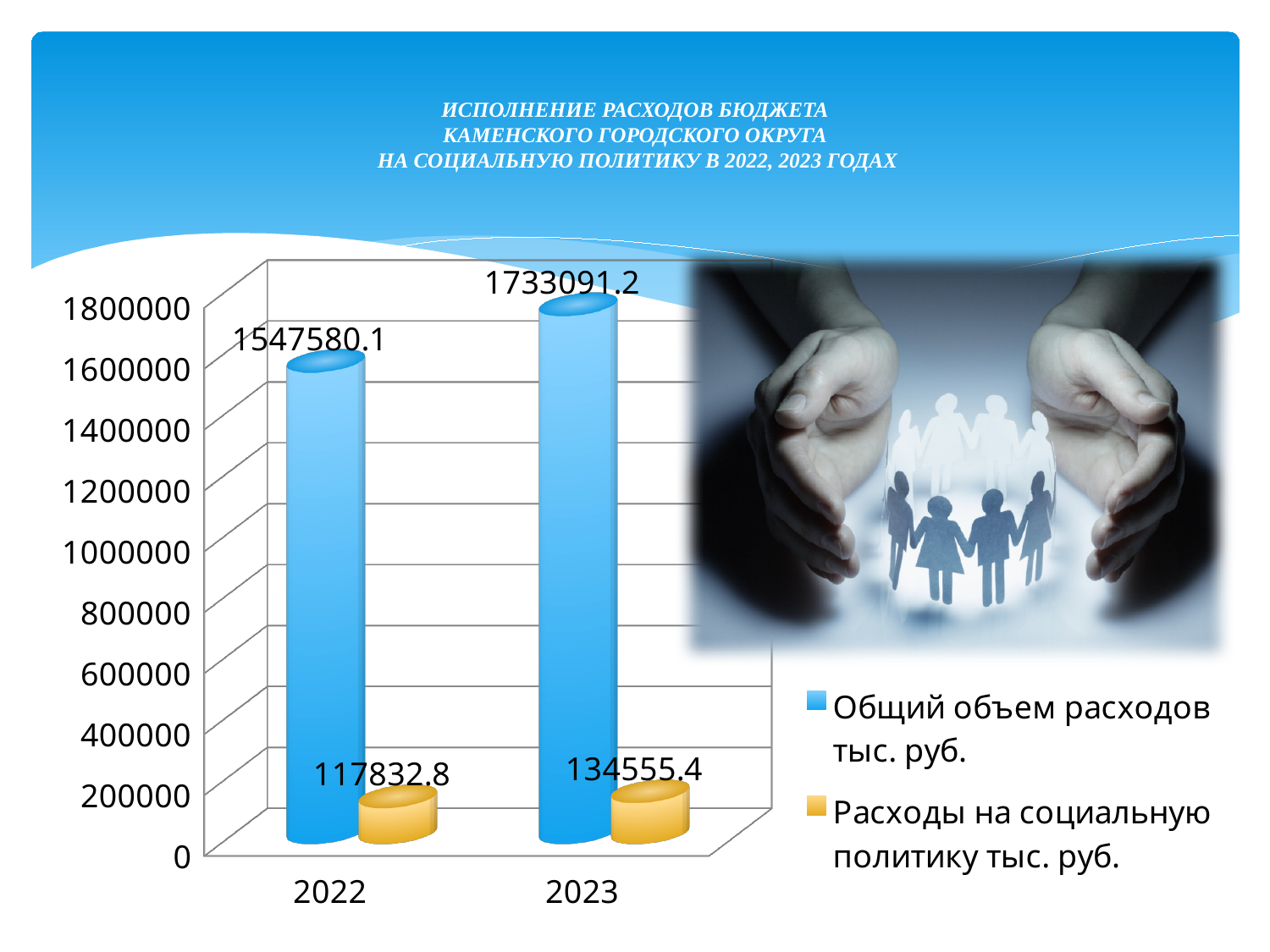
By how much did 'Общий объем расходов тыс. руб.' increase from 2022 to 2023? 185511.1 What is the value of 'Расходы на социальную политику тыс. руб.' for 2022? 117832.8 In which year is 'Общий объем расходов тыс. руб.' highest? 2023 How many series does the legend list? 2 What is the value of 'Общий объем расходов тыс. руб.' for 2023? 1733091.2 What is the value of 'Общий объем расходов тыс. руб.' for 2022? 1547580.1 Does 'Общий объем расходов тыс. руб.' rise or fall from 2022 to 2023? Rise Which is larger: 'Расходы на социальную политику тыс. руб.' in 2022 or in 2023? 2023 In which year is 'Расходы на социальную политику тыс. руб.' lowest? 2022 What is the value of 'Расходы на социальную политику тыс. руб.' for 2023? 134555.4 What is the difference between 'Расходы на социальную политику тыс. руб.' in 2023 and in 2022? 16722.6 What kind of chart is shown on the slide? Bar chart